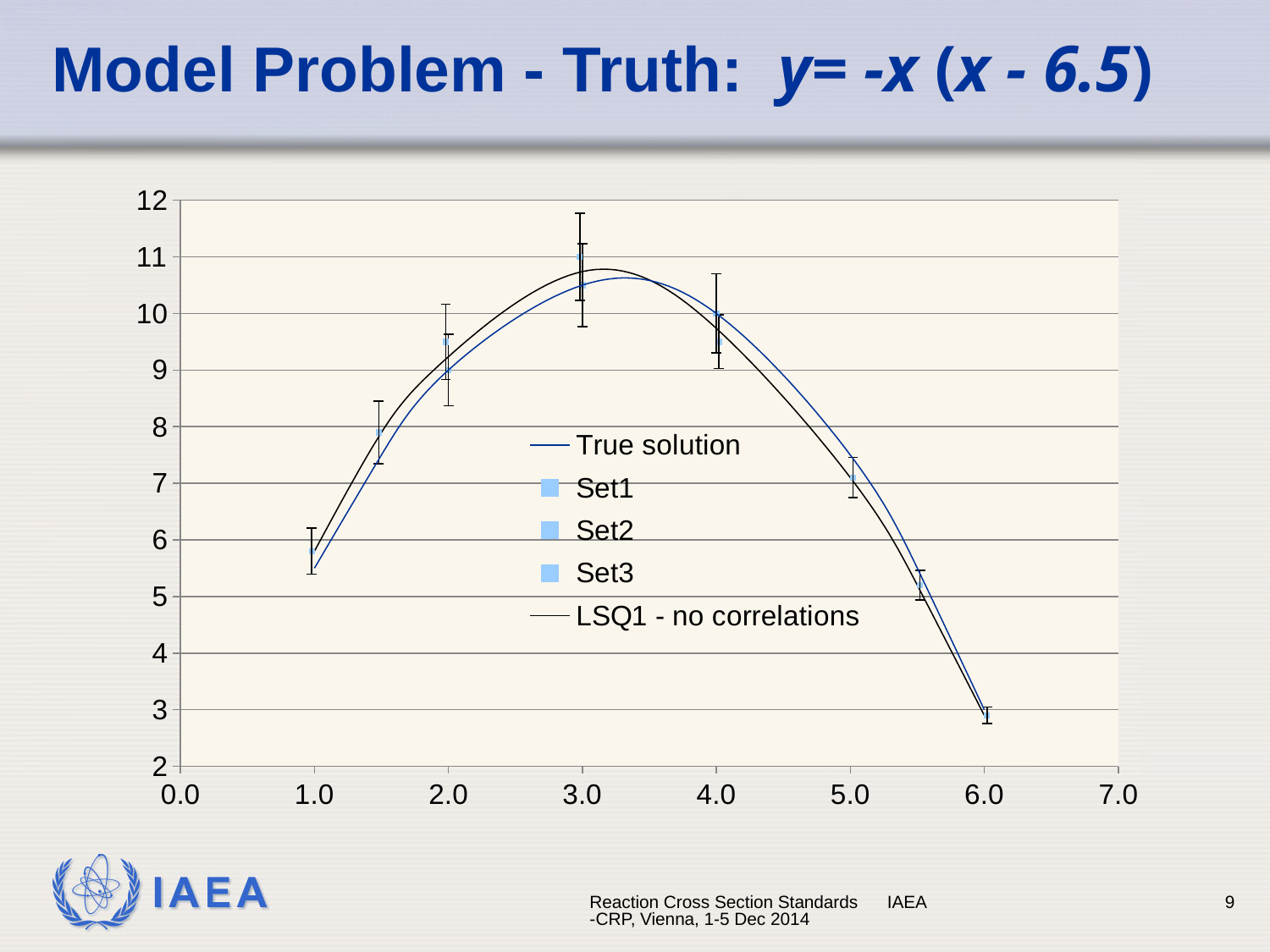
At which x value do the plotted data points reach their highest y value? 3.0 What is the name of the first series listed in the legend? True solution Is the value of the data point at x = 5.0 greater or less than 6? greater Is the value of the data point at x = 1.5 greater or less than 7? greater What is the name of the last series listed in the legend? LSQ1 - no correlations Which data point has the lowest y value, the one at x = 1.0 or the one at x = 6.0? x = 6.0 Is the value of the data point at x = 5.5 greater or less than 6? less What kind of chart is shown on the slide? line chart Do the curves rise or fall as x increases from 4.0 to 6.0? fall How many series does the legend list? 5 Do the curves rise or fall as x increases from 1.0 to 3.0? rise